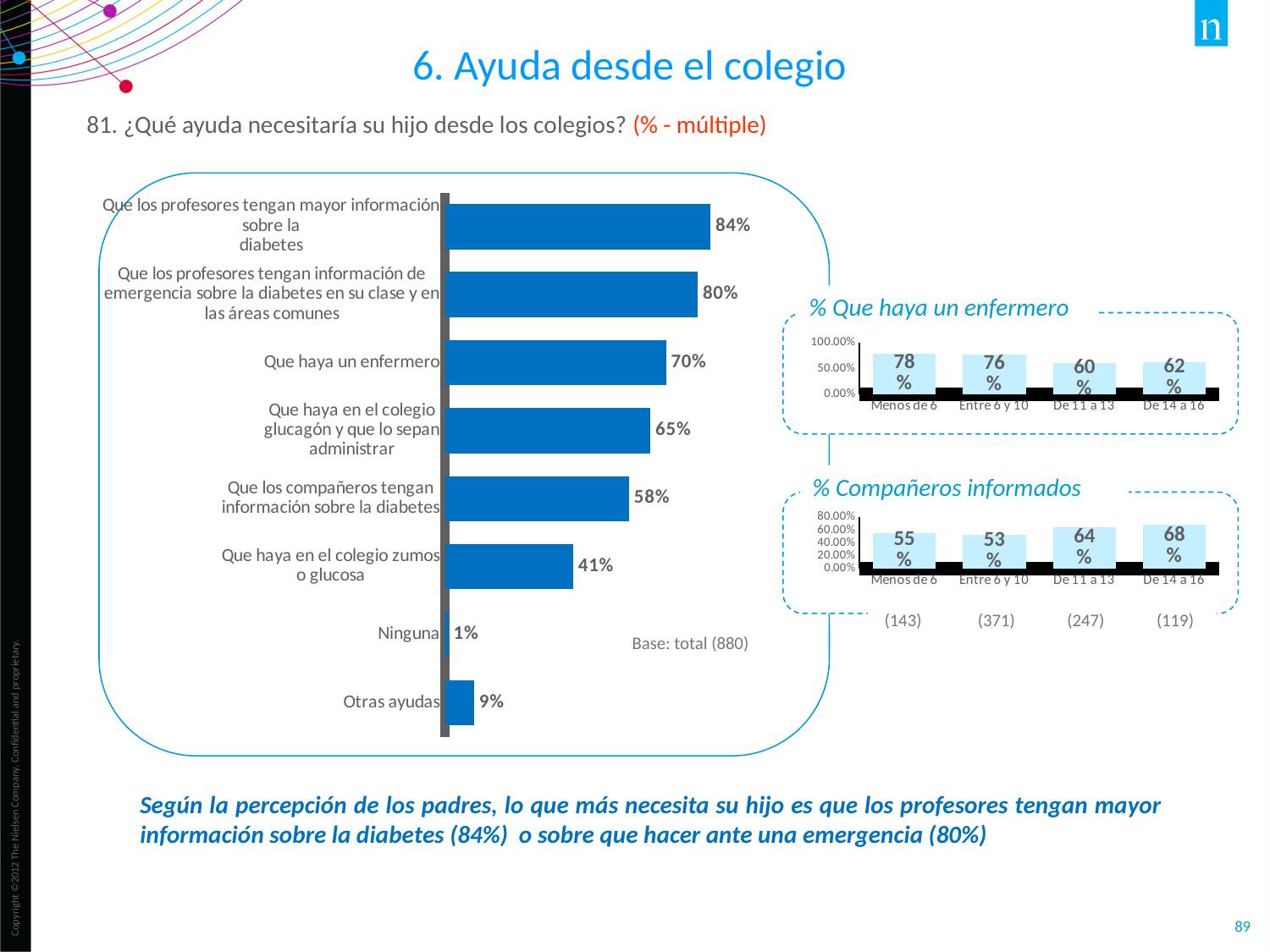
In the main bar chart on the left, what is the value for 'Que haya un enfermero'? 70% What type of chart is the main chart on the left? Bar chart In the main bar chart on the left, what is the difference between 'Que los profesores tengan mayor información sobre la diabetes' and 'Que los compañeros tengan información sobre la diabetes'? 26% In the '% Compañeros informados' chart, what is the difference between 'De 14 a 16' and 'Entre 6 y 10'? 15% In the main bar chart on the left, which category has the highest value? Que los profesores tengan mayor información sobre la diabetes In the main bar chart on the left, how many categories are shown? 8 In the main bar chart on the left, which category has the lowest value? Ninguna In the '% Que haya un enfermero' chart, what is the value for 'Menos de 6'? 78% In the '% Compañeros informados' chart, what is the value for 'De 14 a 16'? 68% In the '% Que haya un enfermero' chart, which age group has the lowest value? De 11 a 13 In the '% Compañeros informados' chart, which is larger: 'Entre 6 y 10' or 'De 11 a 13'? De 11 a 13 In the main bar chart on the left, what is the value for 'Que haya en el colegio zumos o glucosa'? 41%